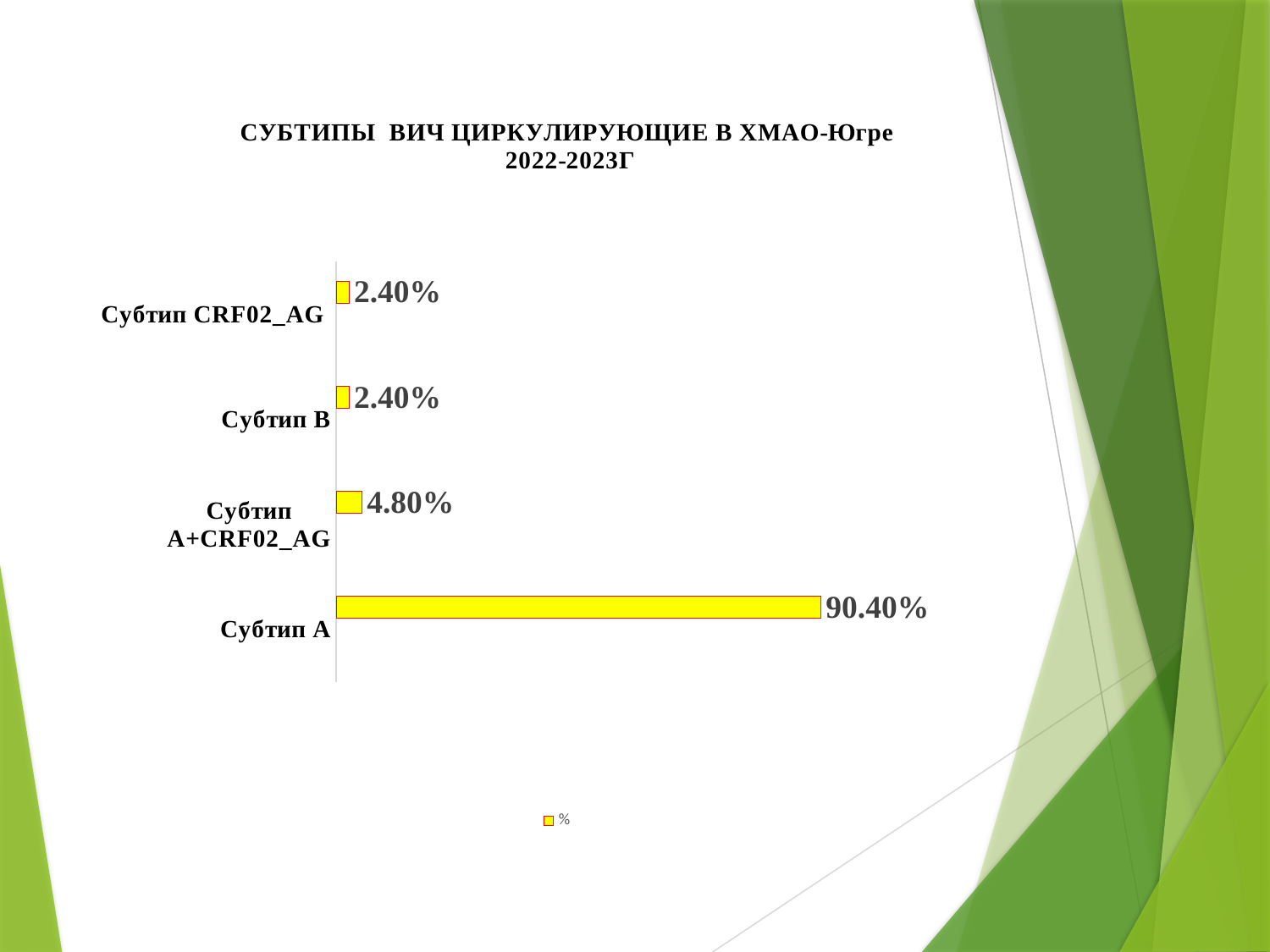
What is the value for Субтип A+CRF02_AG? 4.80% What is the value for Субтип А? 90.40% Which is larger, the value for Субтип A+CRF02_AG or the value for Субтип CRF02_AG? Субтип A+CRF02_AG What is the value for Субтип CRF02_AG? 2.40% What is the difference between the values for Субтип A+CRF02_AG and Субтип B? 2.40% Which category has the highest value? Субтип А How many series does the legend list? 1 What is the value for Субтип B? 2.40% What is the title of the chart? СУБТИПЫ ВИЧ ЦИРКУЛИРУЮЩИЕ В ХМАО-Югре 2022-2023Г What kind of chart is shown on the slide? Bar chart How many categories are shown in the chart? 4 What is the difference between the values for Субтип А and Субтип A+CRF02_AG? 85.60%